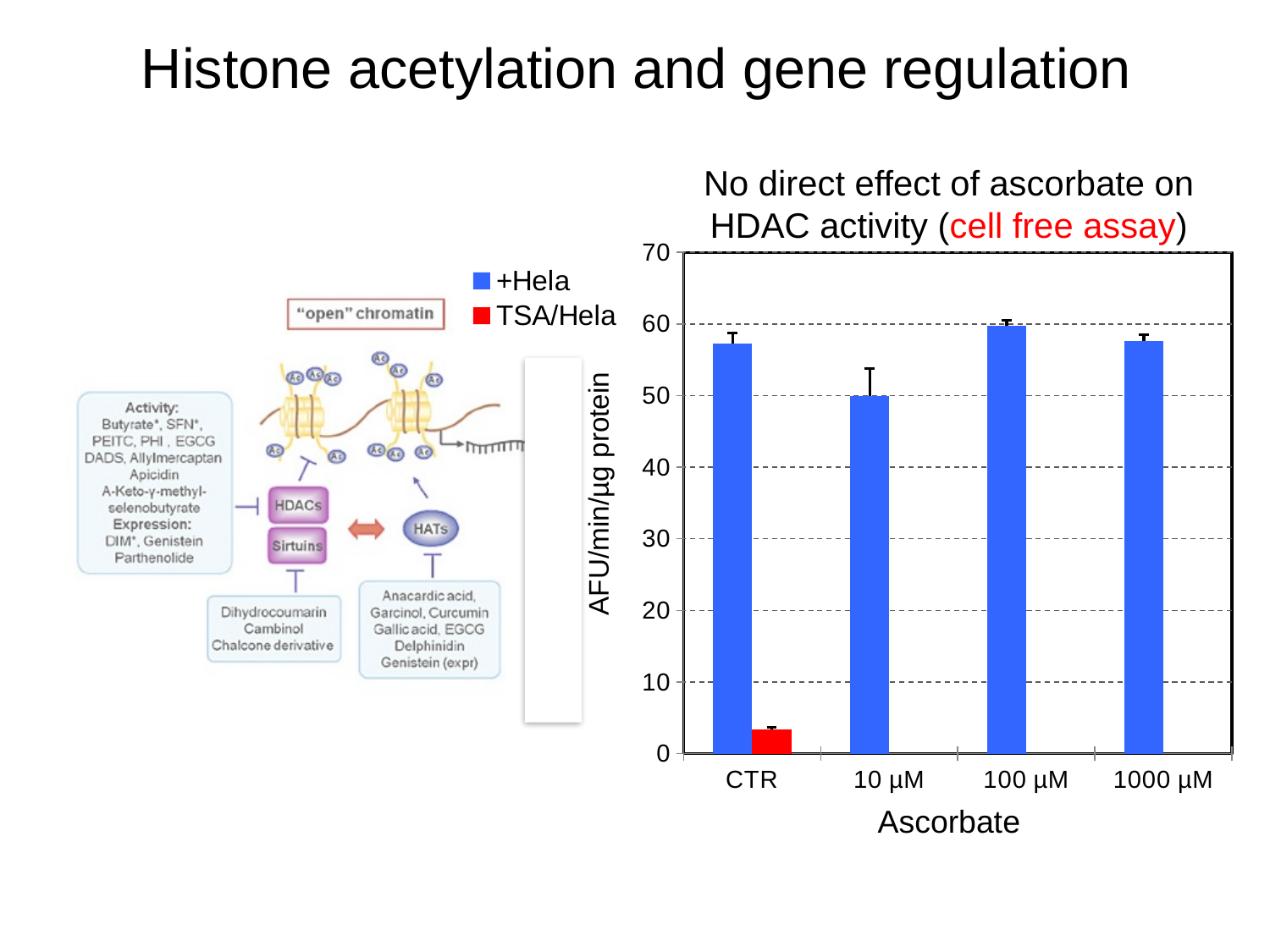
Which colour represents the TSA/Hela series in the chart? red Which is larger at CTR, the +Hela value or the TSA/Hela value? +Hela Is the TSA/Hela value for CTR greater or less than 10? less Which ascorbate concentration has the lowest +Hela value? 10 µM How many categories are shown on the x axis of the chart? 4 What is the label of the chart's y axis? AFU/min/µg protein Is the +Hela value for 100 µM greater or less than 50? greater Is the +Hela value for CTR greater or less than 50? greater Which is larger, the +Hela value for CTR or the +Hela value for 10 µM? CTR What kind of chart is shown on the slide? bar chart How many series does the chart's legend list? 2